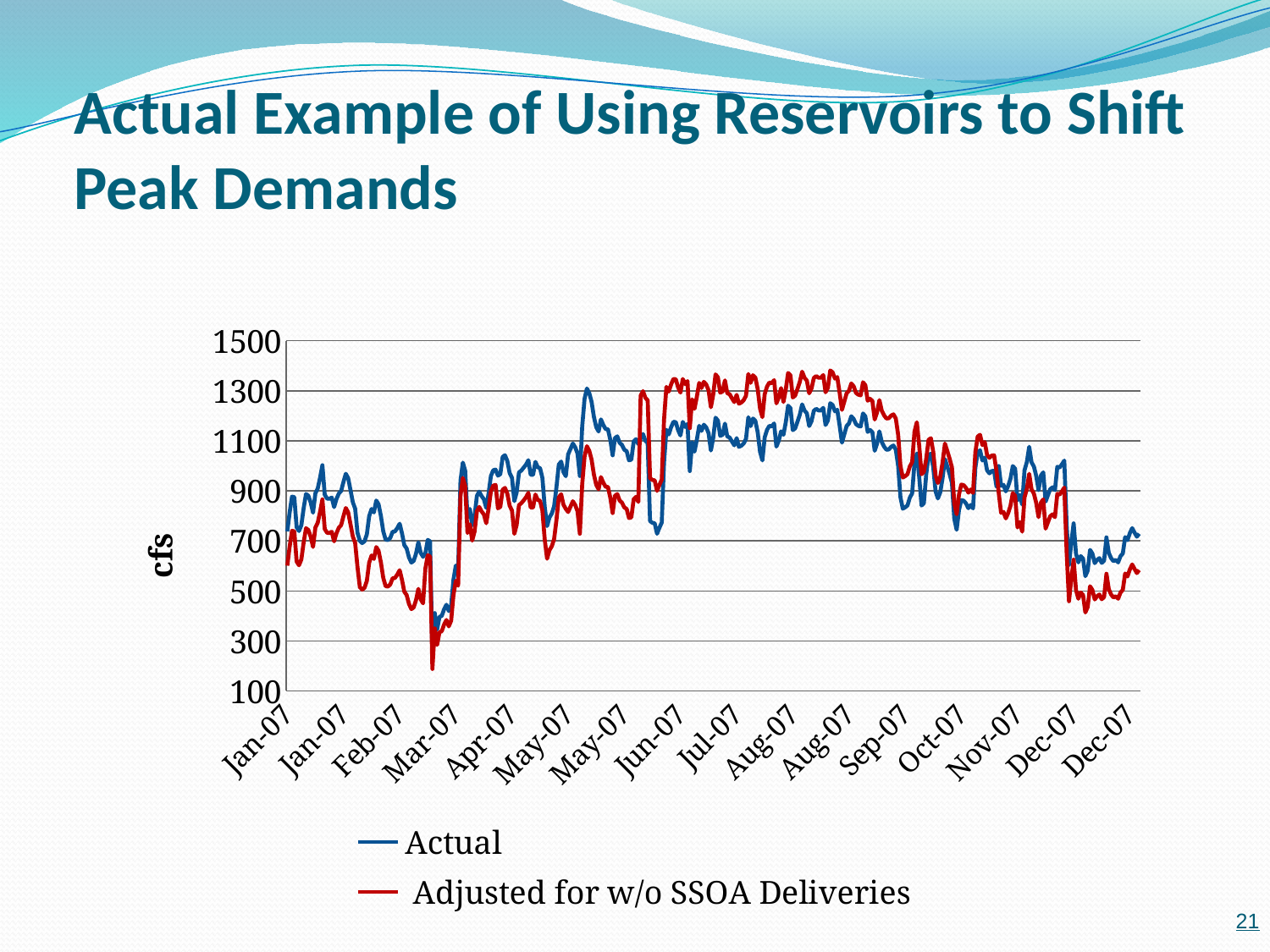
Does the Actual series generally rise or fall from Jan-07 to Aug-07? rise Is the lowest point of the Adjusted for w/o SSOA Deliveries series, near Mar-07, greater or less than 300? less Does the Adjusted for w/o SSOA Deliveries series generally rise or fall from Aug-07 to Dec-07? fall How many series does the legend list? 2 What is the label on the vertical axis? cfs Is the value of the Actual series in late Dec-07 greater or less than 900? less Is the value of the Actual series around Aug-07 greater or less than 1300? less Around Aug-07, which series is higher, Actual or Adjusted for w/o SSOA Deliveries? Adjusted for w/o SSOA Deliveries In late Dec-07, which series is higher, Actual or Adjusted for w/o SSOA Deliveries? Actual Which series is drawn in red? Adjusted for w/o SSOA Deliveries What kind of chart is shown on the slide? line chart